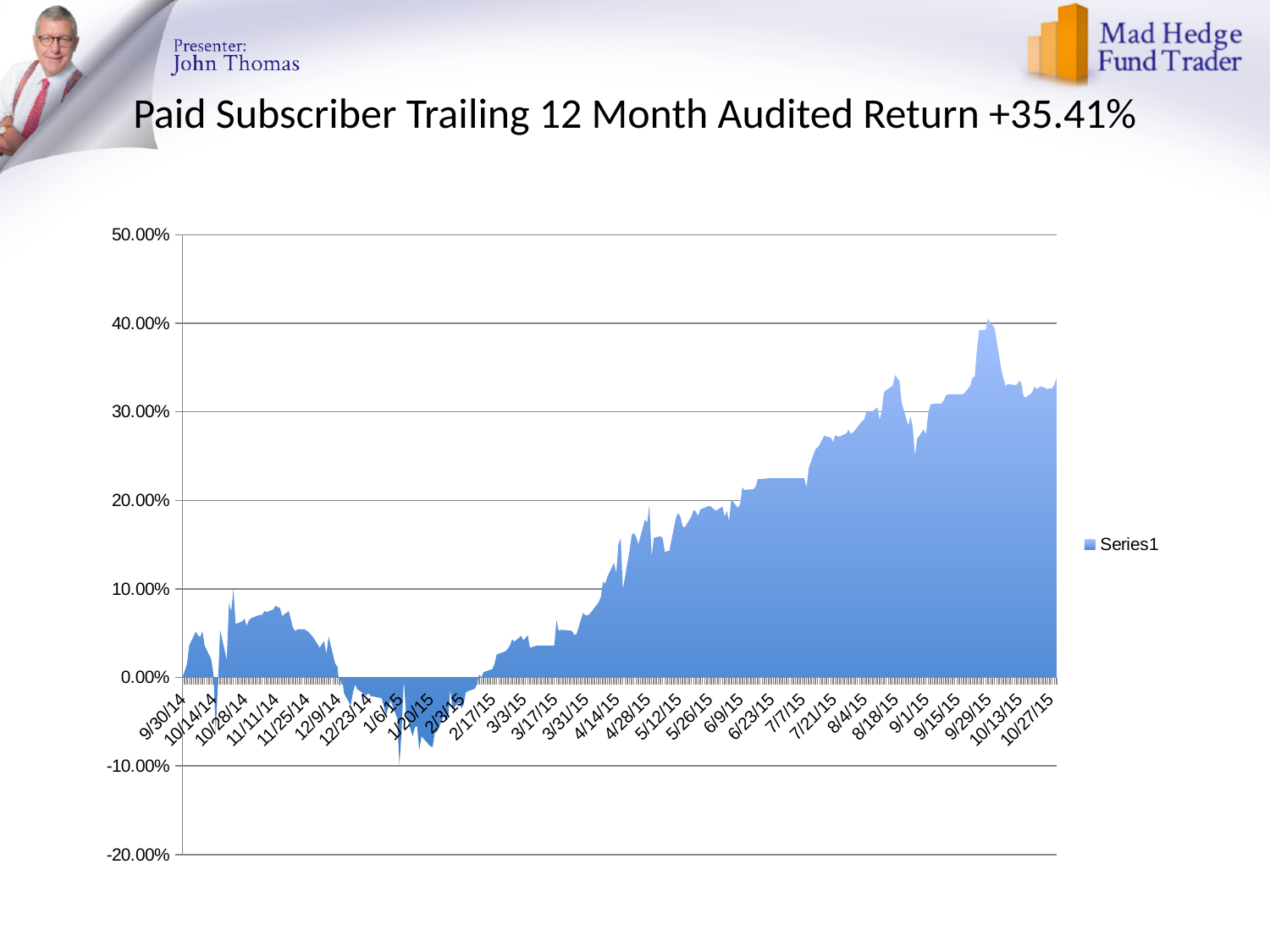
Is the value around 10/27/15 greater or less than 20.00%? greater Is the value around 1/20/15 greater or less than 0.00%? less Is the value around 9/29/15 greater or less than 30.00%? greater Near which labeled date does the chart reach its highest value? 9/29/15 What is the name of the series shown in the legend? Series1 What is the title of the slide above the chart? Paid Subscriber Trailing 12 Month Audited Return +35.41% Overall, do the values rise or fall from 9/30/14 to 10/27/15? Rise How many series does the legend list? 1 What kind of chart is shown on the slide? Area chart Near which labeled date does the chart reach its lowest value? 1/6/15